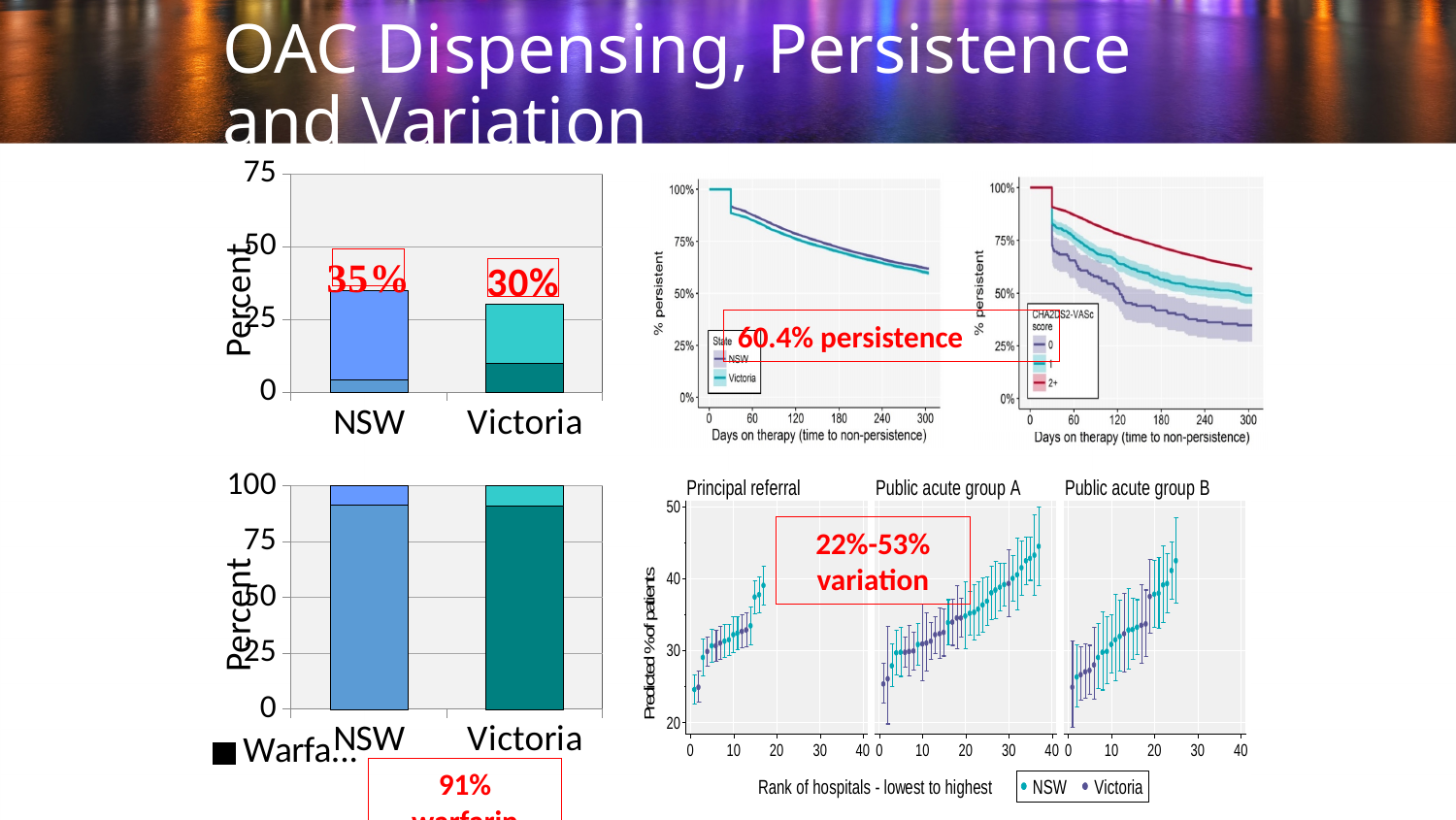
In the top-right line chart labelled by CHA2DS2-VASc score, how many series does the legend list? 3 In the bottom-right chart, how many hospital group panels are shown? 3 In the top-right line charts, do the % persistent values rise or fall as days on therapy increase? fall In the top-left bar chart, is the total height of the NSW bar greater or less than 50? less In the top-left bar chart, which category has the taller stacked bar, NSW or Victoria? NSW In the bottom-left bar chart, is the lower (warfarin) segment of the NSW bar greater or less than 75? greater In the top-right line chart labelled by State, how many series does the legend list? 2 In the top-left bar chart, how many categories are shown on the x axis? 2 In the bottom-right chart, does the predicted % of patients rise or fall as hospital rank increases from lowest to highest? rise What is the y-axis label of the bottom-left bar chart? Percent What type of chart is the top-left chart with the NSW and Victoria bars? bar chart In the top-left bar chart, is the total height of the Victoria bar greater or less than 25? greater